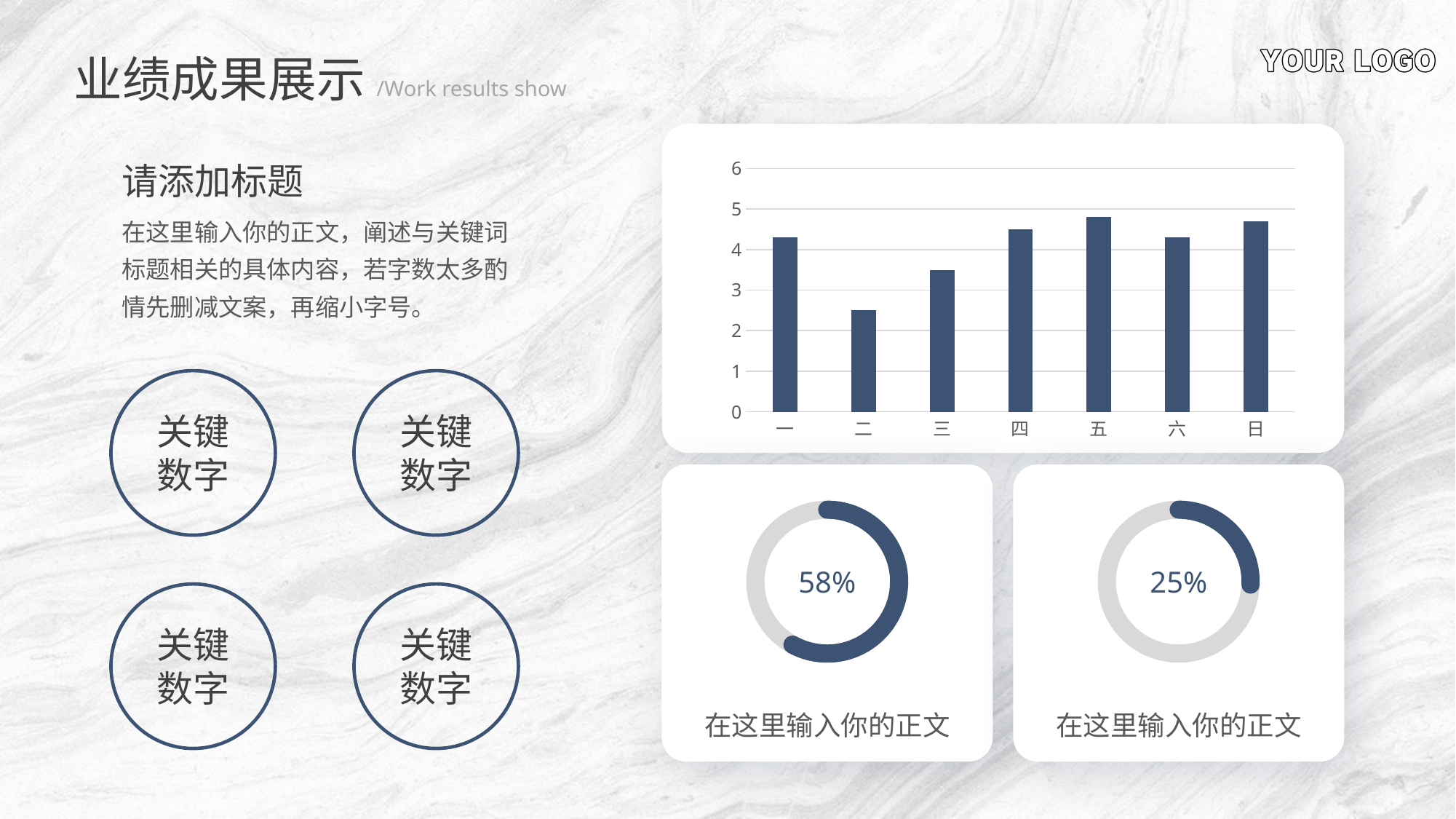
In the bar chart, which is larger, the value for 四 or the value for 二? 四 In the bar chart, is the value for 一 greater or less than 4? greater What colour are the bars in the bar chart? dark blue In the bar chart, how many categories are shown on the x axis? 7 In the bar chart, which category has the lowest bar? 二 In the bar chart, is the value for 二 greater or less than 3? less What kind of chart is shown in the top-right panel of the slide? bar chart In the bar chart, which is larger, the value for 二 or the value for 三? 三 What percentage is shown in the ring chart at the bottom left of the slide? 58% What percentage is shown in the ring chart at the bottom right of the slide? 25% In the bar chart, is the value for 三 greater or less than 3? greater